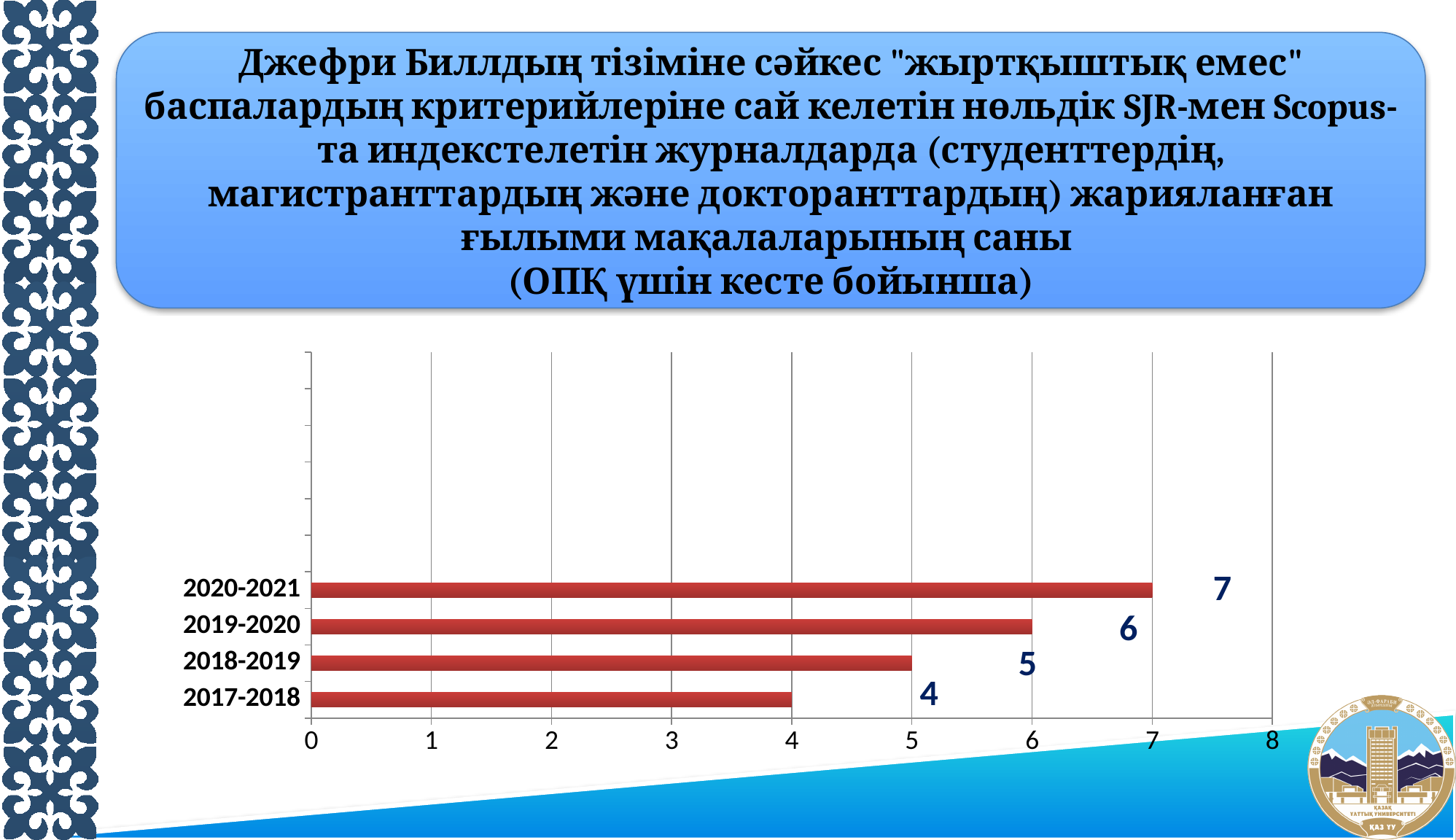
How many periods are shown on the chart? 4 What kind of chart is shown on the slide? Bar chart Which period has the lowest value? 2017-2018 What is the value for 2018-2019? 5 What is the value for 2017-2018? 4 Which period has the highest value? 2020-2021 Which is larger, the value for 2019-2020 or the value for 2018-2019? 2019-2020 Do the values rise or fall from 2017-2018 to 2020-2021? Rise What is the difference between the values for 2020-2021 and 2017-2018? 3 What is the maximum value shown on the horizontal axis? 8 What is the value for 2019-2020? 6 What is the value for 2020-2021? 7